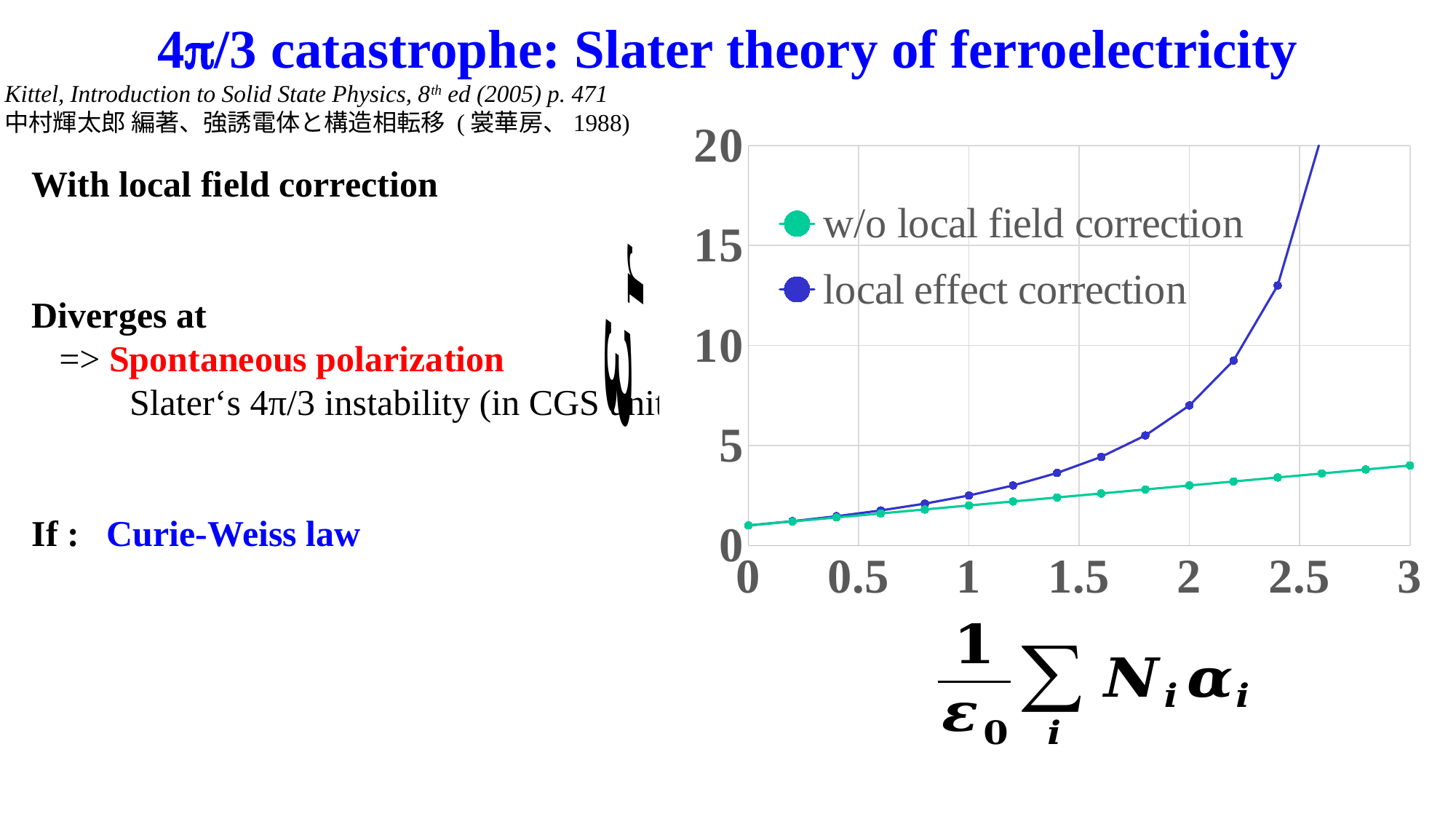
At x = 2, which series has the larger value, 'w/o local field correction' or 'local effect correction'? local effect correction Do the values of the 'local effect correction' series rise or fall as the x-axis value increases? rise How many series does the chart legend list? 2 Which colour is used for the 'local effect correction' series? blue What kind of chart is shown on the slide? line chart Is the value of the 'w/o local field correction' series at x = 3 greater or less than 5? less What is the highest value shown on the chart's y axis? 20 Do the values of the 'w/o local field correction' series rise or fall along the x axis? rise Is the value of the 'local effect correction' series at x = 2.4 greater or less than 10? greater What are the two series named in the chart legend? w/o local field correction; local effect correction Is the value of the 'w/o local field correction' series at x = 2 greater or less than 5? less